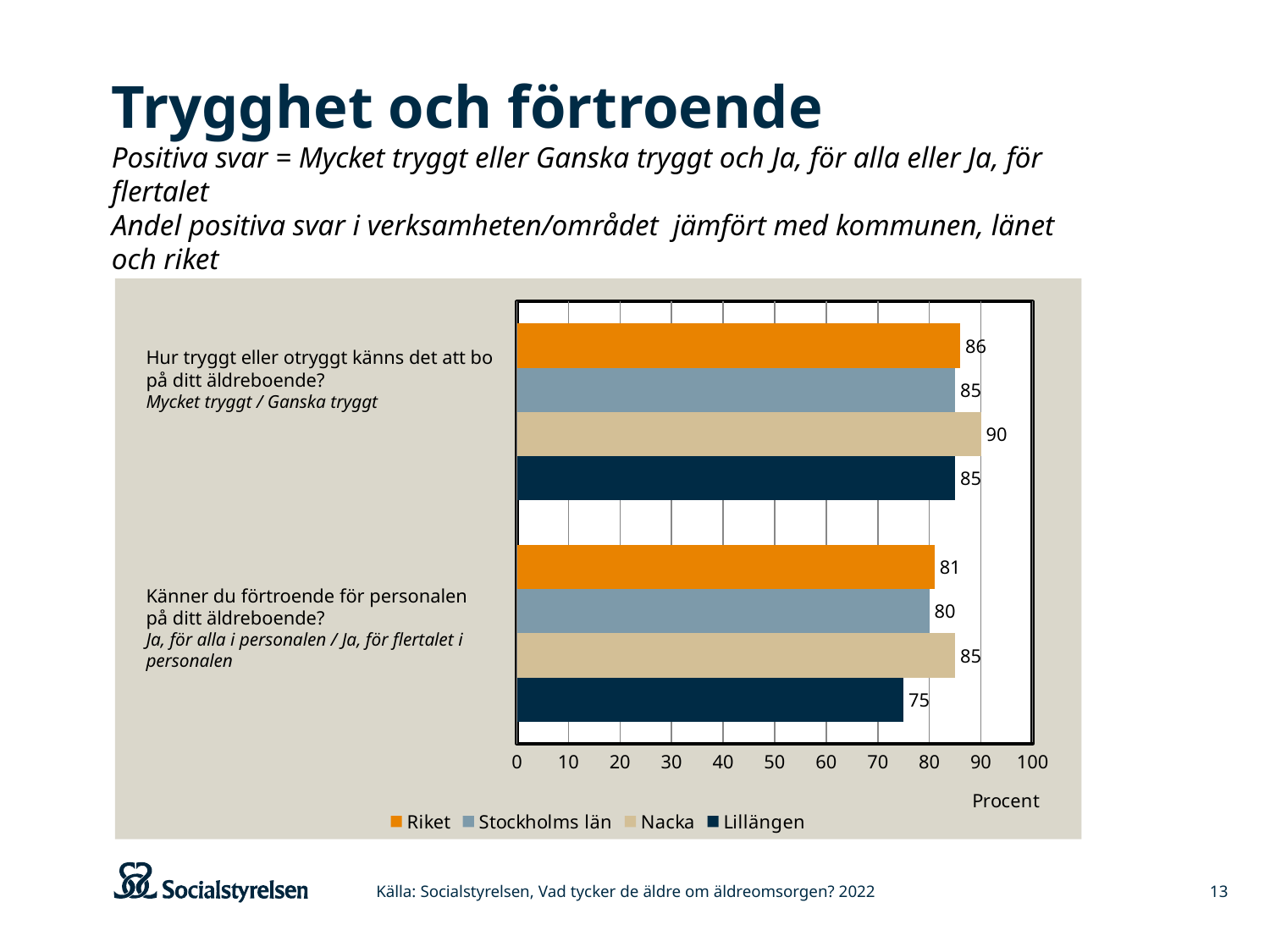
What is the value for Stockholms län on the question "Hur tryggt eller otryggt känns det att bo på ditt äldreboende?"? 85 What kind of chart is shown on the slide? Bar chart Which series has the lowest value on the question "Känner du förtroende för personalen på ditt äldreboende?"? Lillängen What is the difference between Nacka and Riket on the question "Hur tryggt eller otryggt känns det att bo på ditt äldreboende?"? 4 What unit is shown on the x axis of the chart? Procent What is the value for Nacka on the question "Hur tryggt eller otryggt känns det att bo på ditt äldreboende?"? 90 What is the value for Lillängen on the question "Känner du förtroende för personalen på ditt äldreboende?"? 75 How many series does the legend list? 4 What is the difference between Nacka and Lillängen on the question "Känner du förtroende för personalen på ditt äldreboende?"? 10 What is the value for Riket on the question "Känner du förtroende för personalen på ditt äldreboende?"? 81 Which series has the highest value on the question "Känner du förtroende för personalen på ditt äldreboende?"? Nacka Which is larger on the question "Känner du förtroende för personalen på ditt äldreboende?": Riket or Lillängen? Riket